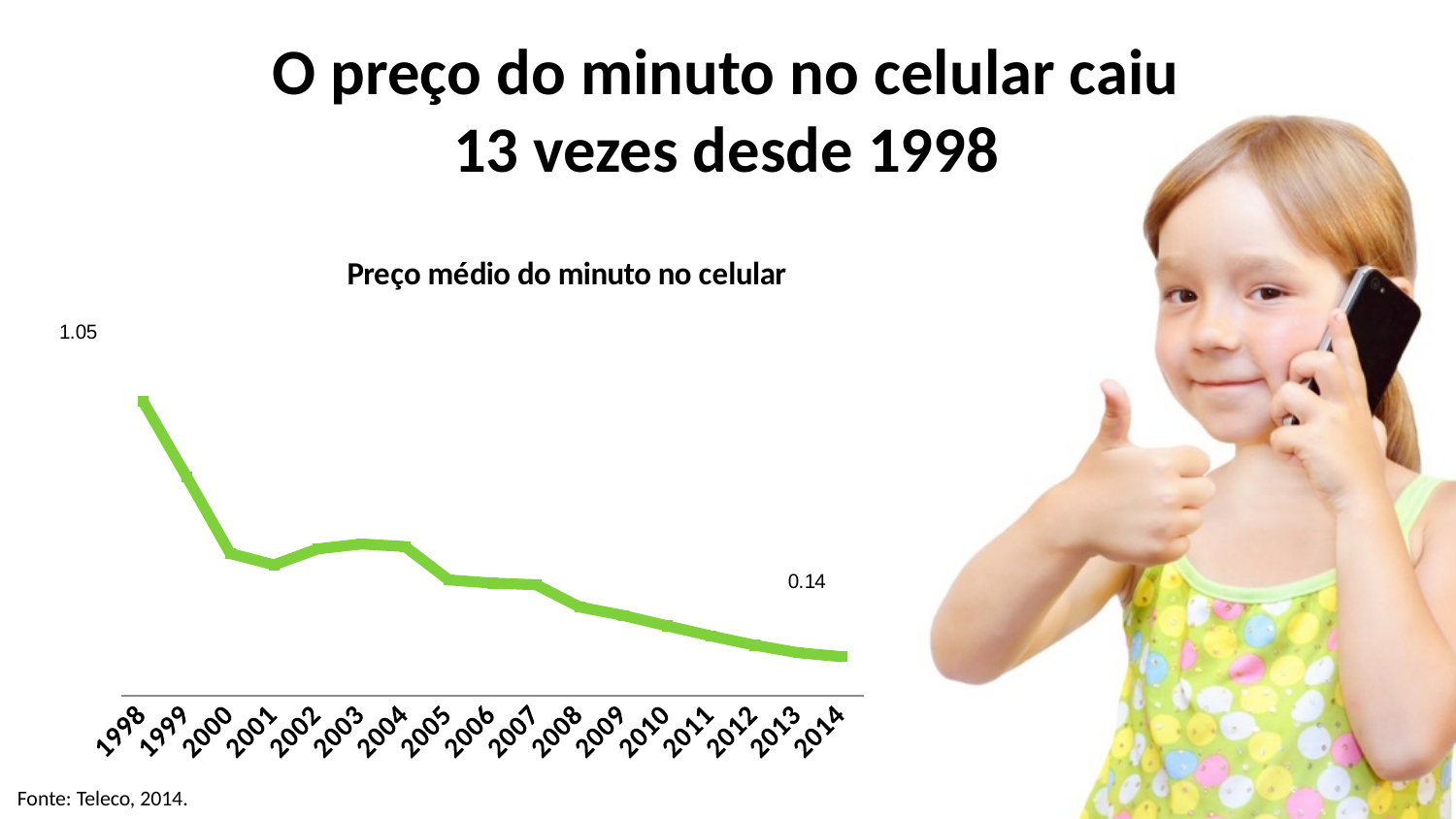
Which year has the highest value? 1998 Do the values generally rise or fall from 1998 to 2014? fall What is the value for 1998? 1.05 What is the value for 2014? 0.14 Which year has the lowest value? 2014 What type of chart is shown on the slide? line chart Which is larger, the value for 1998 or the value for 2014? 1998 What is the difference between the value for 1998 and the value for 2014? 0.91 Which is larger, the value for 2000 or the value for 2010? 2000 What is the title of the chart? Preço médio do minuto no celular What colour is the line in the chart? green How many years are plotted on the x axis? 17